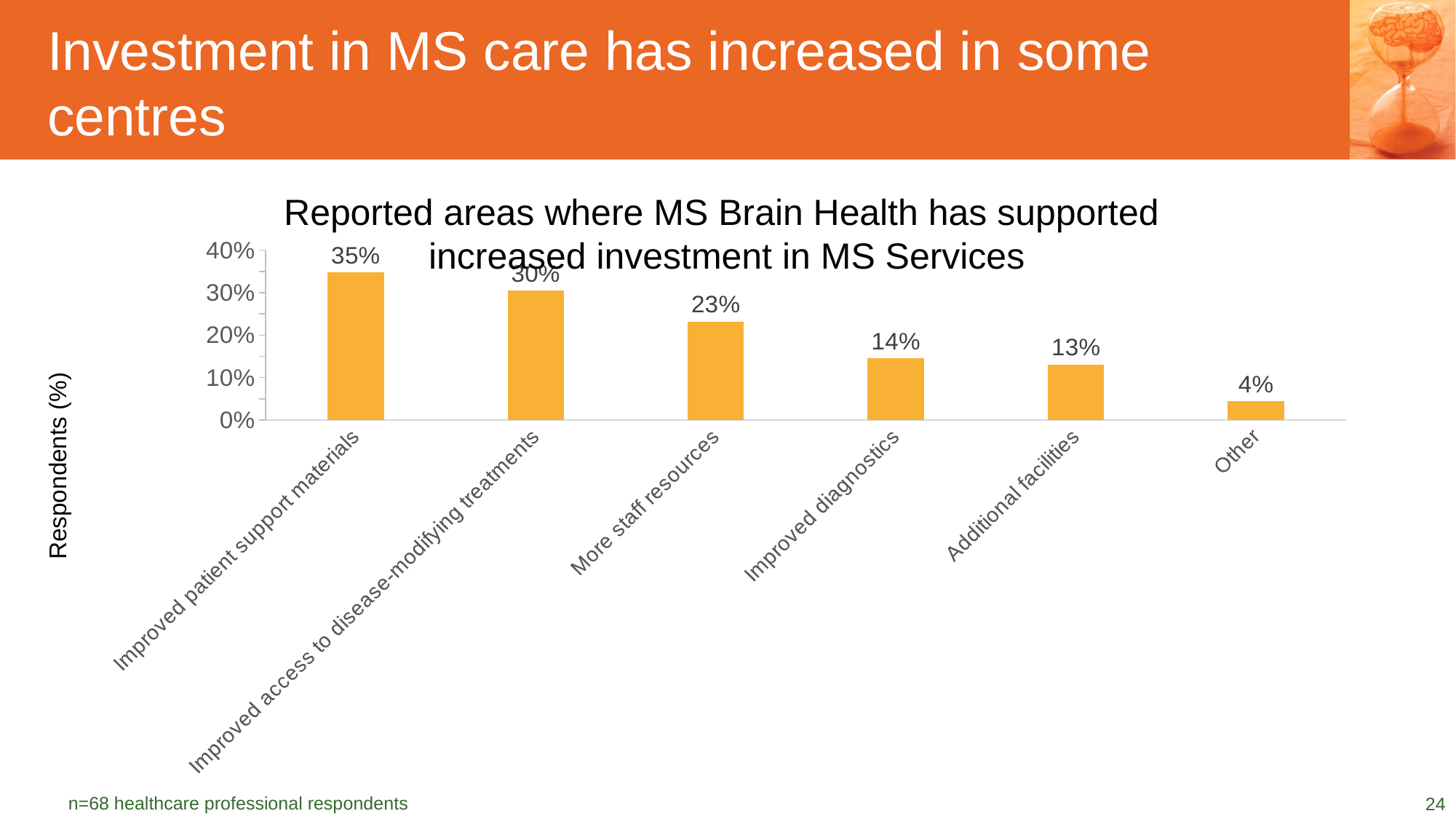
What percentage of respondents reported improved diagnostics? 14% Which category has the lowest value? Other What is the label of the vertical axis? Respondents (%) Which category has the highest value? Improved patient support materials What kind of chart is shown on the slide? Bar chart What is the value for Additional facilities? 13% What is the value for Other? 4% Which is larger, More staff resources or Improved diagnostics? More staff resources What is the value for More staff resources? 23% What percentage of respondents reported improved patient support materials? 35% How many categories are shown in the chart? 6 What is the difference between Improved patient support materials and More staff resources? 12%